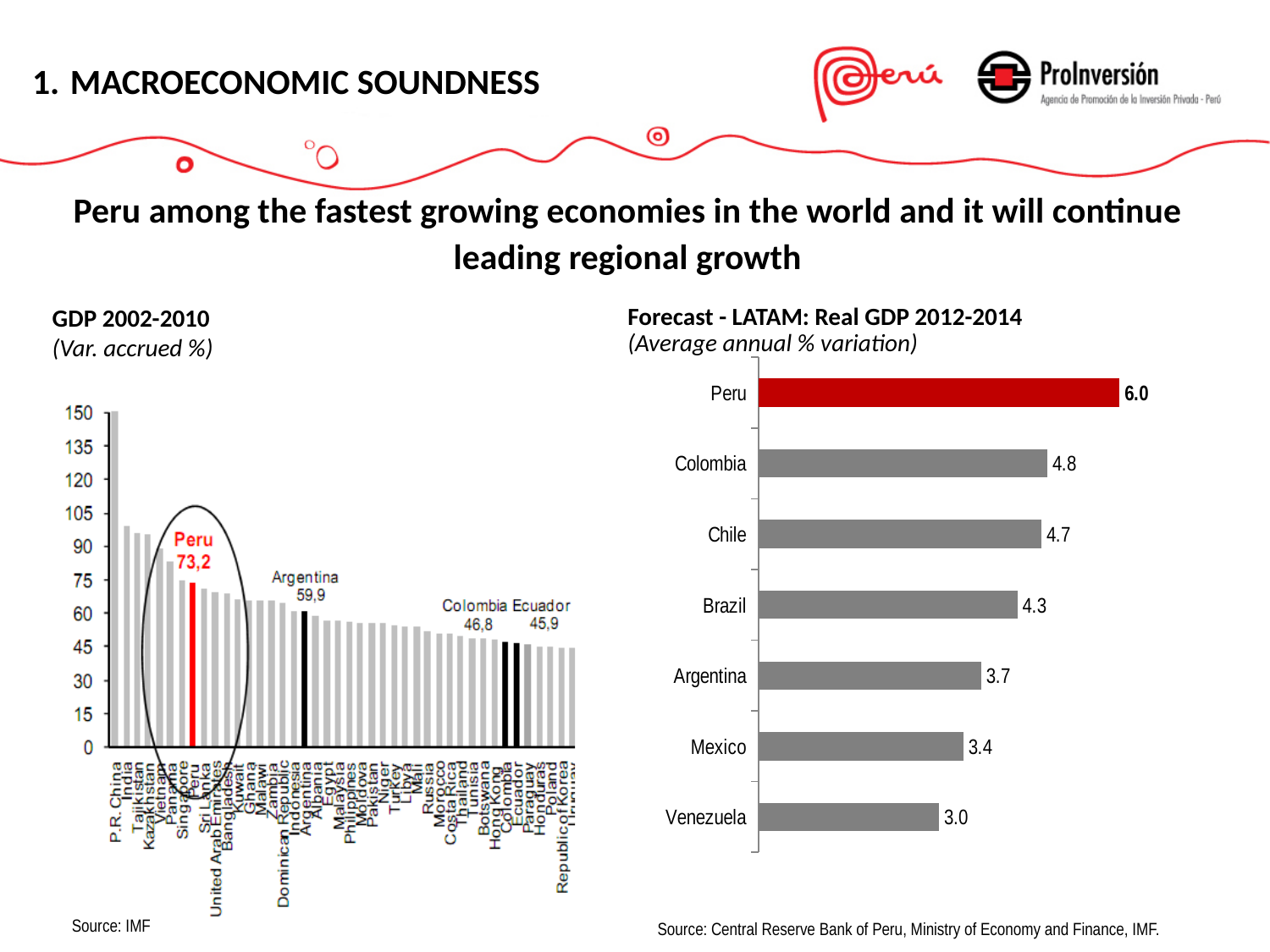
In the Forecast - LATAM: Real GDP 2012-2014 chart, which country has the highest value? Peru In the Forecast - LATAM: Real GDP 2012-2014 chart, what is the difference between the values for Peru and Colombia? 1.2 In the GDP 2002-2010 chart, what is the difference between the values for Colombia and Ecuador? 0,9 In the Forecast - LATAM: Real GDP 2012-2014 chart, which is larger, the value for Argentina or the value for Mexico? Argentina In the Forecast - LATAM: Real GDP 2012-2014 chart, what is the value for Brazil? 4.3 What kind of chart is the Forecast - LATAM: Real GDP 2012-2014 chart? Bar chart In the GDP 2002-2010 chart, what is the value for Peru? 73,2 In the GDP 2002-2010 chart, is the value for P.R. China greater or less than 135? greater In the Forecast - LATAM: Real GDP 2012-2014 chart, what is the value for Peru? 6.0 In the Forecast - LATAM: Real GDP 2012-2014 chart, how many countries are shown? 7 In the GDP 2002-2010 chart, what is the value for Argentina? 59,9 In the Forecast - LATAM: Real GDP 2012-2014 chart, which country has the lowest value? Venezuela